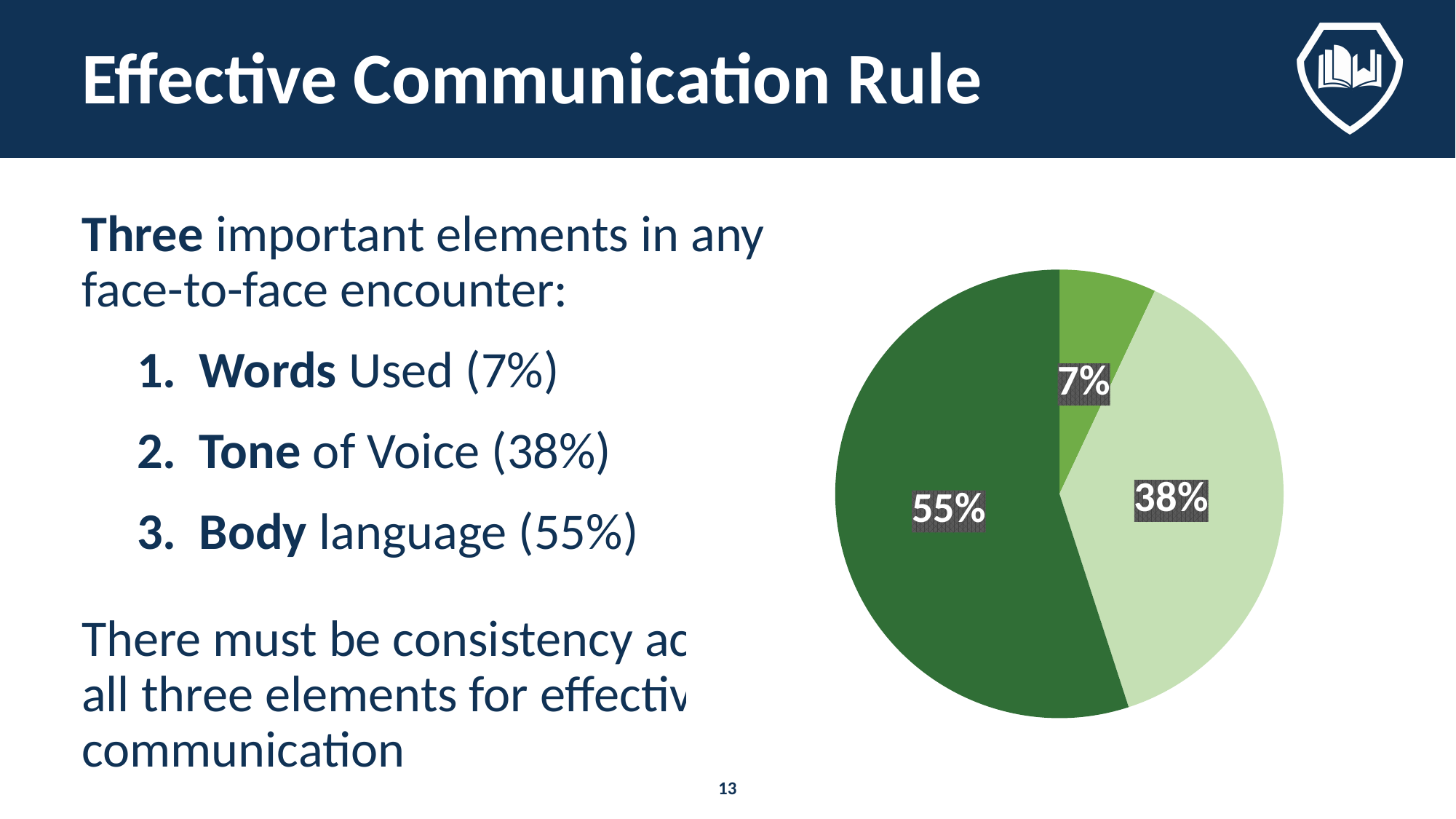
What is the difference between the 55% slice and the 38% slice? 17% What share of the pie does the light green slice represent? 38% What is the smallest slice of the pie chart? 7% According to the slide, what percentage is attributed to Body language? 55% According to the slide, what percentage is attributed to Words Used? 7% How many slices does the pie chart have? 3 Which is larger, the slice for Tone of Voice or the slice for Words Used? Tone of Voice What is the largest slice of the pie chart? 55% What share of the pie does the dark green slice represent? 55% What kind of chart is shown on the slide? pie chart According to the slide, what percentage is attributed to Tone of Voice? 38% Does the pie chart have a legend? No